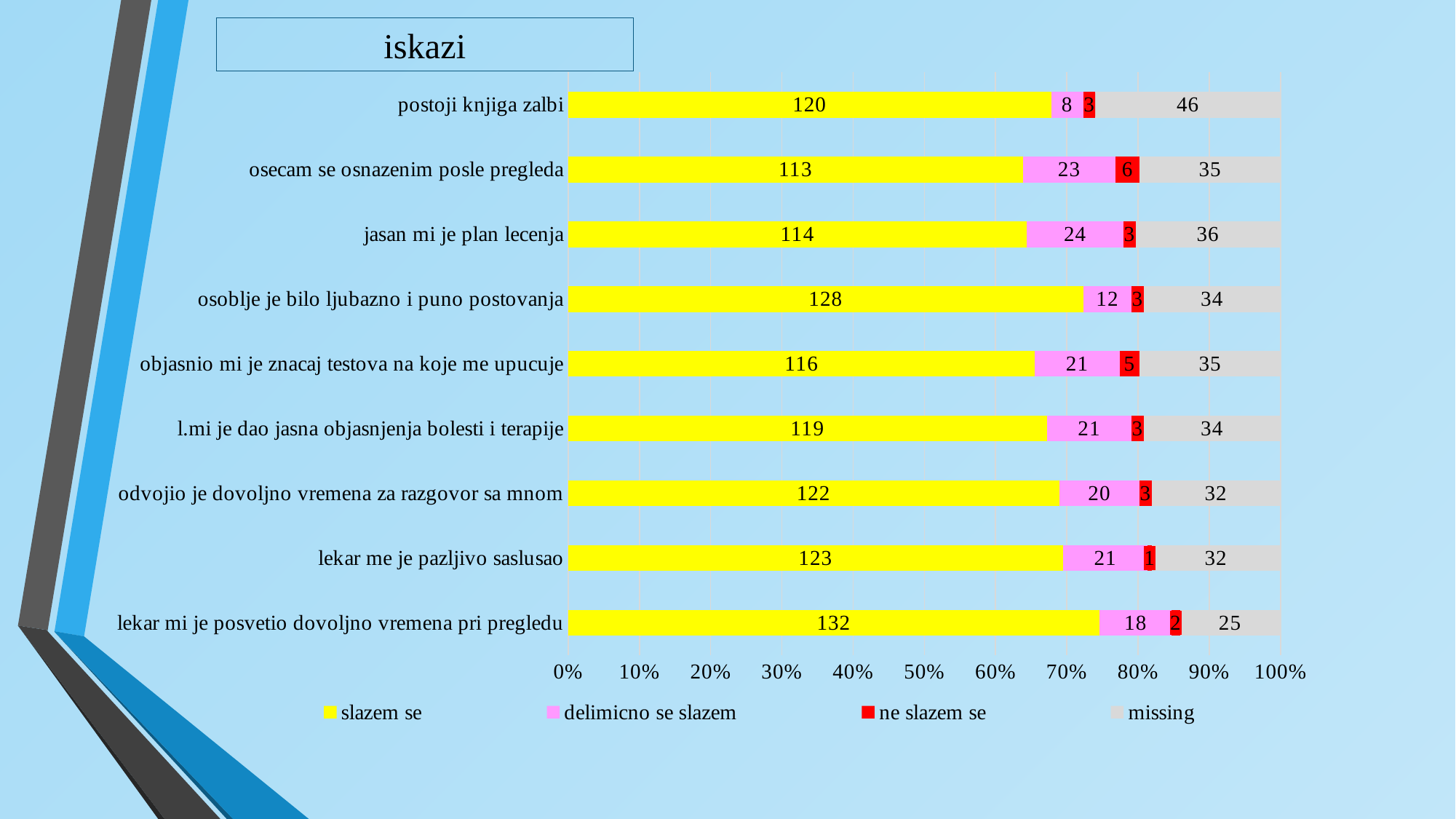
What is the total of all four segments in the bar for 'lekar mi je posvetio dovoljno vremena pri pregledu'? 177 What is the difference between the 'slazem se' values for 'lekar me je pazljivo saslusao' and 'objasnio mi je znacaj testova na koje me upucuje'? 7 Which statement has the lowest 'slazem se' value? osecam se osnazenim posle pregleda What kind of chart is shown on the slide? stacked bar chart What is the 'delimicno se slazem' value for 'osoblje je bilo ljubazno i puno postovanja'? 12 What is the 'missing' value for 'jasan mi je plan lecenja'? 36 Which is larger: the 'ne slazem se' value for 'osecam se osnazenim posle pregleda' or for 'objasnio mi je znacaj testova na koje me upucuje'? osecam se osnazenim posle pregleda How many categories (statements) are plotted on the chart? 9 What is the 'slazem se' value for 'postoji knjiga zalbi'? 120 Which statement has the highest 'slazem se' value? lekar mi je posvetio dovoljno vremena pri pregledu Which statement has the highest 'missing' value? postoji knjiga zalbi How many series does the legend list? 4